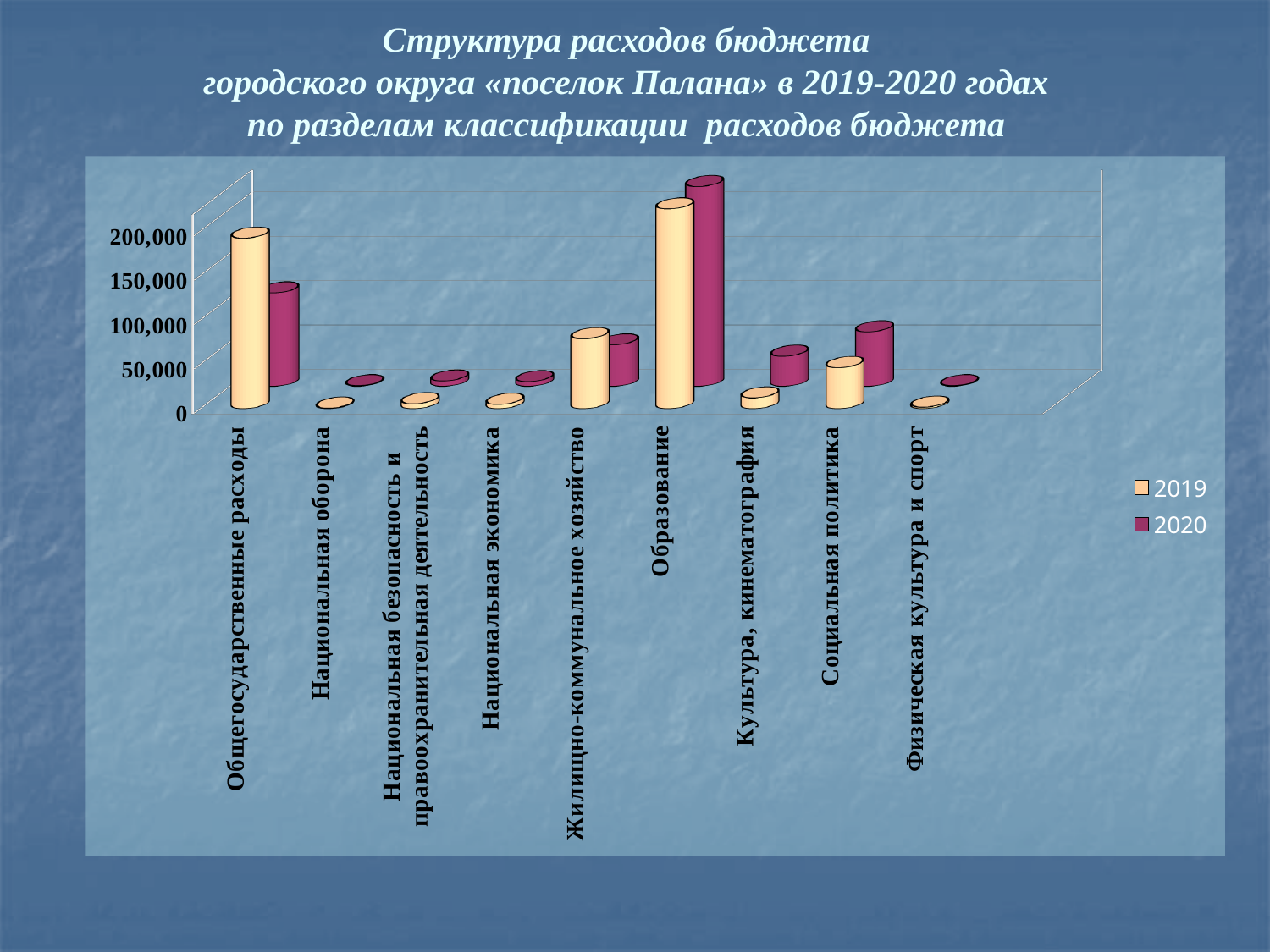
For Общегосударственные расходы, which year has the larger value, 2019 or 2020? 2019 Which series is shown in the magenta colour in the legend? 2020 Which category has the highest value for 2019? Образование Which category has the highest value for 2020? Образование For Культура, кинематография, which year has the larger value, 2019 or 2020? 2020 For Социальная политика, which year has the larger value, 2019 or 2020? 2020 How many series does the chart legend list? 2 How many categories are shown on the x axis of the chart? 9 Is the 2019 value for Образование greater or less than 200,000? greater What kind of chart is shown on the slide? bar chart Is the 2019 value for Национальная оборона greater or less than 50,000? less